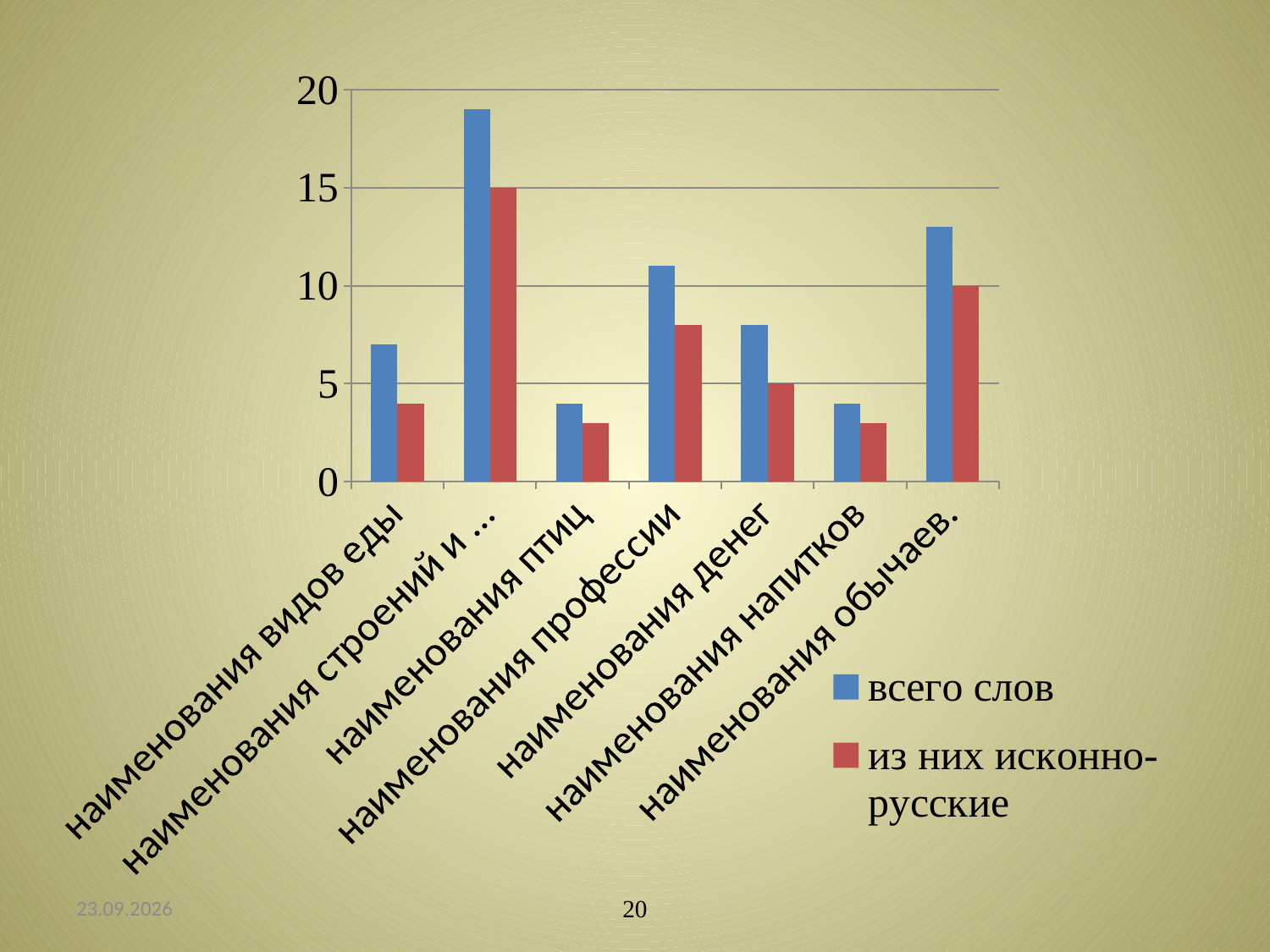
How many series does the chart's legend list? 2 Is the value of "всего слов" for "наименования строений и …" greater or less than 15? greater How many categories are shown on the x axis of the chart? 7 What kind of chart is shown on the slide? bar chart Is the value of "из них исконно-русские" for "наименования профессии" greater or less than 5? greater Which is larger: the "всего слов" value for "наименования профессии" or for "наименования денег"? наименования профессии Which category has the highest value for "всего слов"? наименования строений и … Which category has the highest value for "из них исконно-русские"? наименования строений и … Which is larger: the "всего слов" value for "наименования обычаев." or for "наименования видов еды"? наименования обычаев. Is the value of "всего слов" for "наименования напитков" greater or less than 5? less What colour are the bars for the series "из них исконно-русские"? red